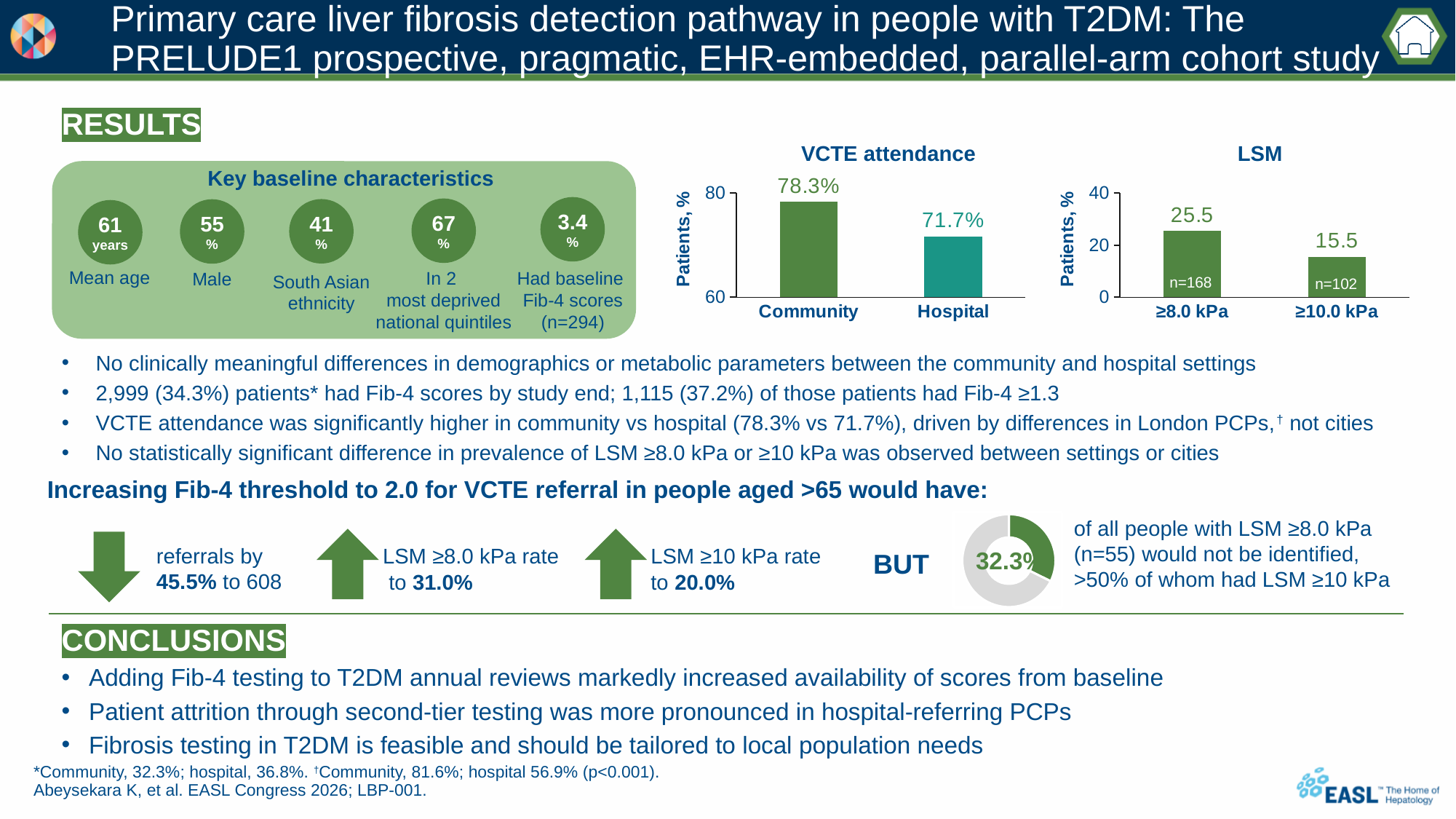
In the VCTE attendance chart, what is the difference between the Community and Hospital values? 6.6% In the VCTE attendance chart, which category has the higher value? Community In the VCTE attendance chart, how many categories are shown? 2 In the VCTE attendance chart, what is the value for Community? 78.3% In the LSM chart, which category has the lower value? ≥10.0 kPa In the LSM chart, what is the n shown on the ≥10.0 kPa bar? n=102 In the LSM chart, what is the value for ≥10.0 kPa? 15.5 In the LSM chart, what is the n shown on the ≥8.0 kPa bar? n=168 What kind of chart is the VCTE attendance chart? Bar chart In the VCTE attendance chart, what is the value for Hospital? 71.7% In the LSM chart, what is the difference between the ≥8.0 kPa and ≥10.0 kPa values? 10 In the LSM chart, what is the value for ≥8.0 kPa? 25.5